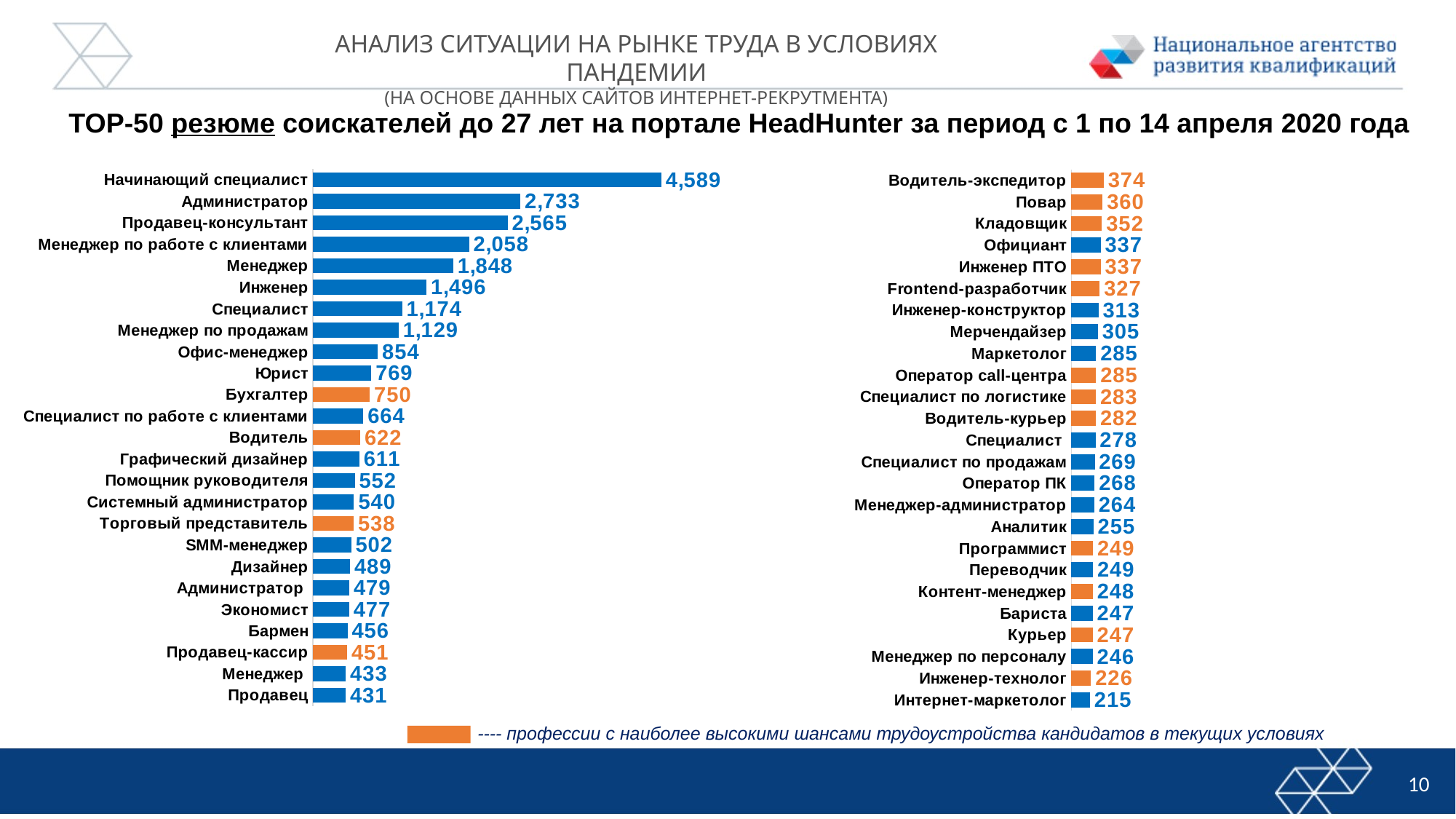
In the left chart, which is larger: Офис-менеджер or Юрист? Офис-менеджер In the right chart, which category has the lowest value? Интернет-маркетолог In the left chart, what is the value for Юрист? 769 What type of chart is used on this slide? Bar chart In the right chart, what is the difference between the values for Кладовщик and Инженер-технолог? 126 In the right chart, what is the value for Повар? 360 In the left chart, what is the difference between the values for Бухгалтер and Водитель? 128 In the right chart, which category has the highest value? Водитель-экспедитор In the left chart, which category has the lowest value? Продавец How many categories are shown in the left chart? 25 In the left chart, what colour is the bar for Торговый представитель? Orange In the left chart, which category has the highest value? Начинающий специалист